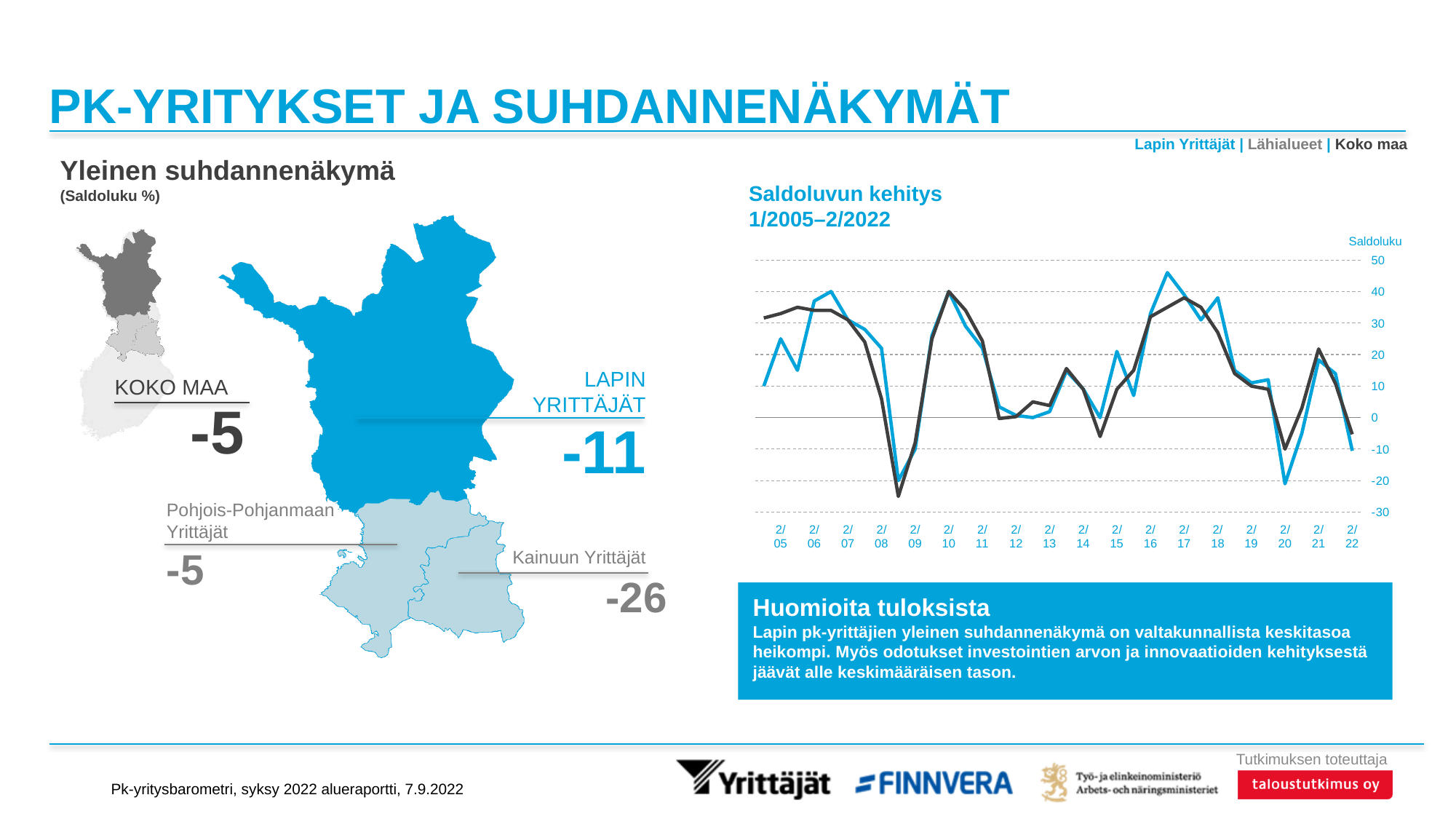
On the map chart 'Yleinen suhdannenäkymä', what is the value shown for Kainuun Yrittäjät? -26 In the chart 'Saldoluvun kehitys 1/2005–2/2022', does the dark Koko maa line rise or fall between 2/17 and 2/20? fall What is the title of the line chart on the right side of the slide? Saldoluvun kehitys 1/2005–2/2022 On the map chart 'Yleinen suhdannenäkymä', what is the difference between the Koko maa value and the Lapin Yrittäjät value? 6 On the map chart 'Yleinen suhdannenäkymä', what is the value shown for Lapin Yrittäjät? -11 On the map chart 'Yleinen suhdannenäkymä', which is larger, the value for Lapin Yrittäjät or the value for Pohjois-Pohjanmaan Yrittäjät? Pohjois-Pohjanmaan Yrittäjät What kind of chart is 'Saldoluvun kehitys 1/2005–2/2022'? line chart In the chart 'Saldoluvun kehitys 1/2005–2/2022', how many time points are labelled on the x axis? 18 On the map chart 'Yleinen suhdannenäkymä', what is the value shown for Koko maa? -5 In the chart 'Saldoluvun kehitys 1/2005–2/2022', is the value of the blue Lapin Yrittäjät line at 2/20 greater or less than -10? less On the map chart 'Yleinen suhdannenäkymä', which region has the lowest value? Kainuun Yrittäjät